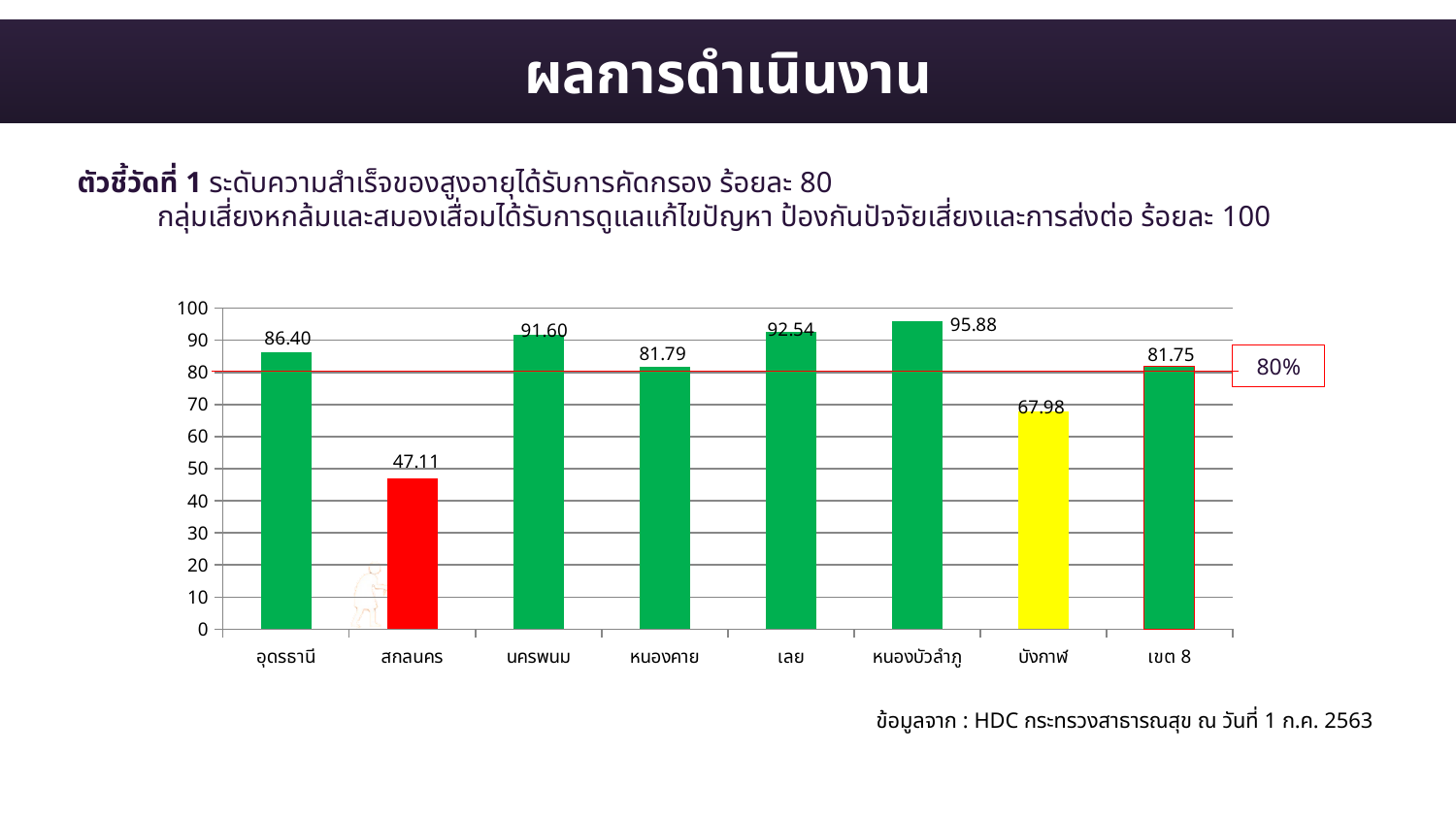
Which category has the highest value? หนองบัวลำภู What kind of chart is shown on the slide? bar chart How many categories are shown on the x axis? 8 What percentage does the red horizontal line on the chart mark? 80% Is the value for บึงกาฬ greater or less than 80? less Which is larger, the value for เลย or the value for หนองคาย? เลย What is the value for เขต 8? 81.75 What is the value for หนองบัวลำภู? 95.88 What is the difference between the values for นครพนม and บึงกาฬ? 23.62 Which category has the lowest value? สกลนคร What is the value for อุดรธานี? 86.40 What is the value for สกลนคร? 47.11